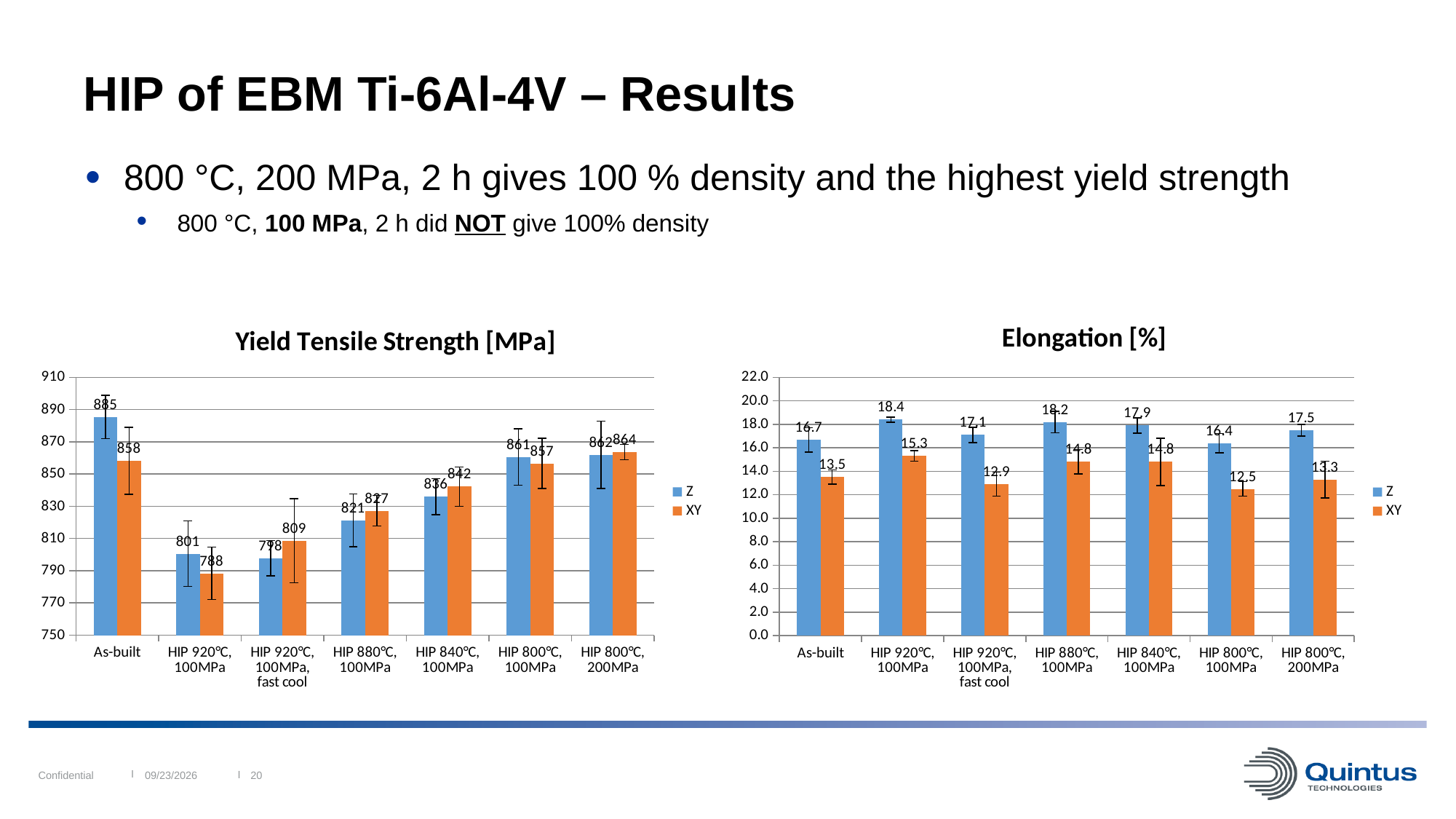
How many series does the legend of the Elongation [%] chart list? 2 In the Elongation [%] chart, what is the XY value for HIP 800℃, 100MPa? 12.5 What kind of chart is the Yield Tensile Strength [MPa] chart on the left? Bar chart In the Yield Tensile Strength [MPa] chart, what is the difference between the Z and XY values for As-built? 27 In the Elongation [%] chart, which series has the larger value for As-built, Z or XY? Z In the Yield Tensile Strength [MPa] chart, what is the Z value for As-built? 885 How many categories are shown on the x axis of the Yield Tensile Strength [MPa] chart? 7 In the Elongation [%] chart, what is the XY value for HIP 920℃, 100MPa? 15.3 In the Elongation [%] chart, which category has the highest Z value? HIP 920℃, 100MPa In the Elongation [%] chart, what is the difference between the Z and XY values for HIP 920℃, 100MPa? 3.1 In the Elongation [%] chart, which category has the lowest XY value? HIP 800℃, 100MPa In the Yield Tensile Strength [MPa] chart, which category has the lowest XY value? HIP 920℃, 100MPa